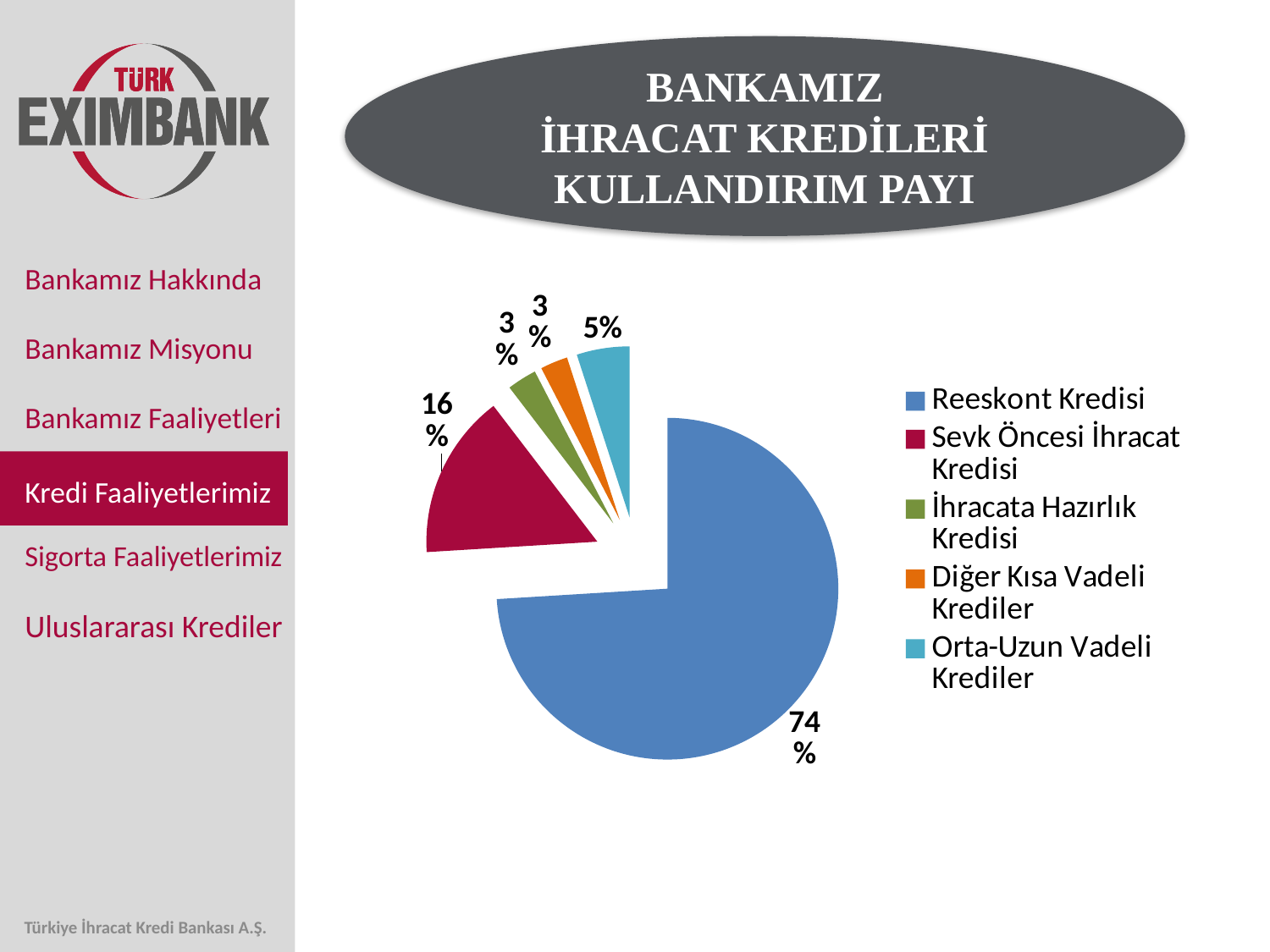
How many slices does the pie chart have? 5 Which is larger, the share for Orta-Uzun Vadeli Krediler or the share for Diğer Kısa Vadeli Krediler? Orta-Uzun Vadeli Krediler Which category has the largest slice of the pie? Reeskont Kredisi What kind of chart is shown on the slide? pie chart What share of the pie does Sevk Öncesi İhracat Kredisi have? 16% What share of the pie does Reeskont Kredisi have? 74% How many entries does the legend list? 5 What is the difference in percentage points between Reeskont Kredisi and Sevk Öncesi İhracat Kredisi? 58 What share of the pie does Orta-Uzun Vadeli Krediler have? 5% What colour is the slice for Sevk Öncesi İhracat Kredisi? dark red